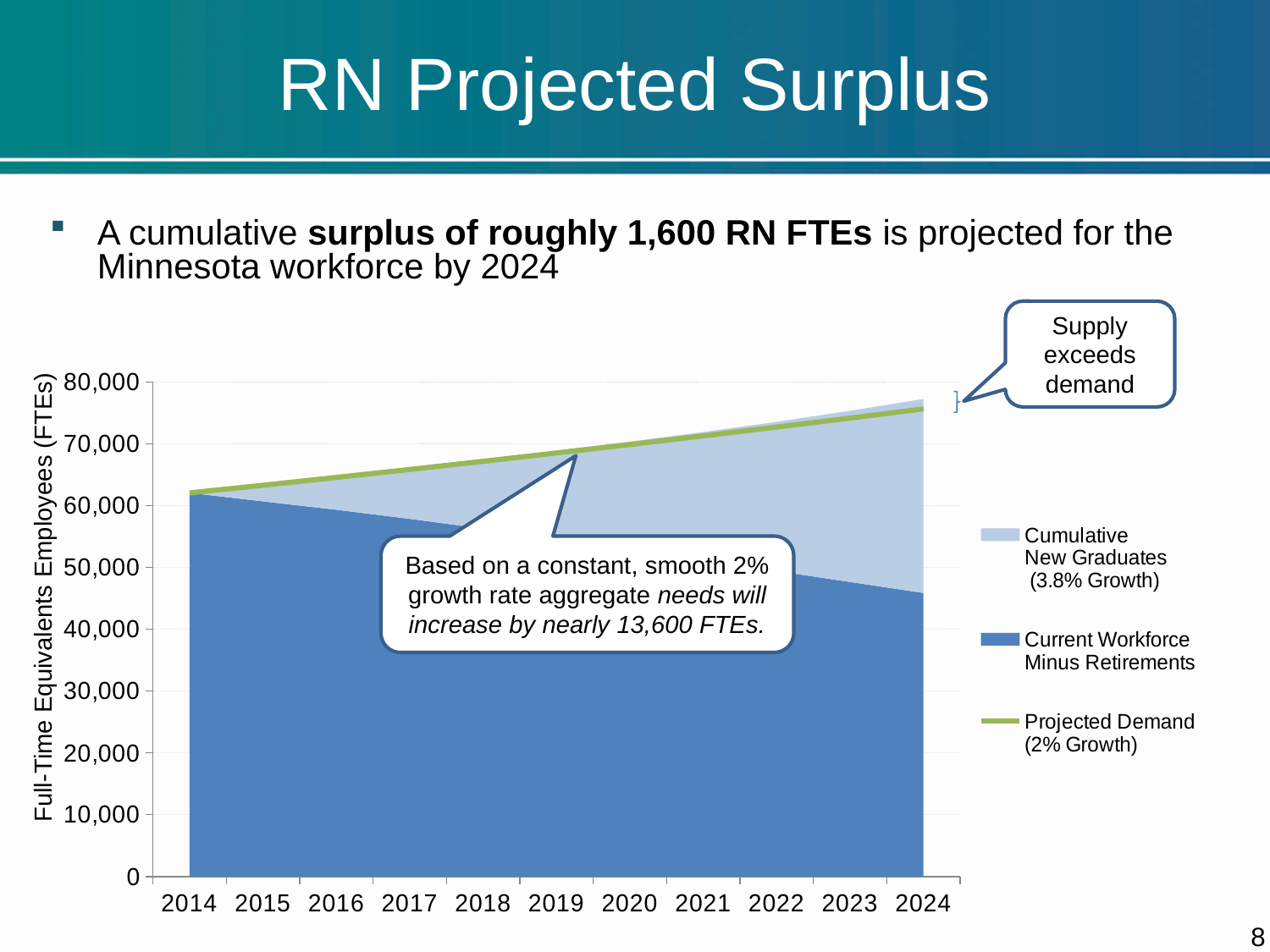
How many series does the chart's legend list? 3 Is the value for Current Workforce Minus Retirements in 2014 greater or less than 60,000? greater Does the Projected Demand (2% Growth) line rise or fall from 2014 to 2024? Rise Does the Current Workforce Minus Retirements series rise or fall from 2014 to 2024? Fall Is the value for Projected Demand (2% Growth) in 2014 greater or less than 70,000? less What is the first year shown on the x axis of the chart? 2014 How many years are shown along the x axis of the chart? 11 What is the label of the chart's y axis? Full-Time Equivalents Employees (FTEs) Is the value for Projected Demand (2% Growth) in 2024 greater or less than 70,000? greater What kind of chart is shown on the slide? Combination area and line chart